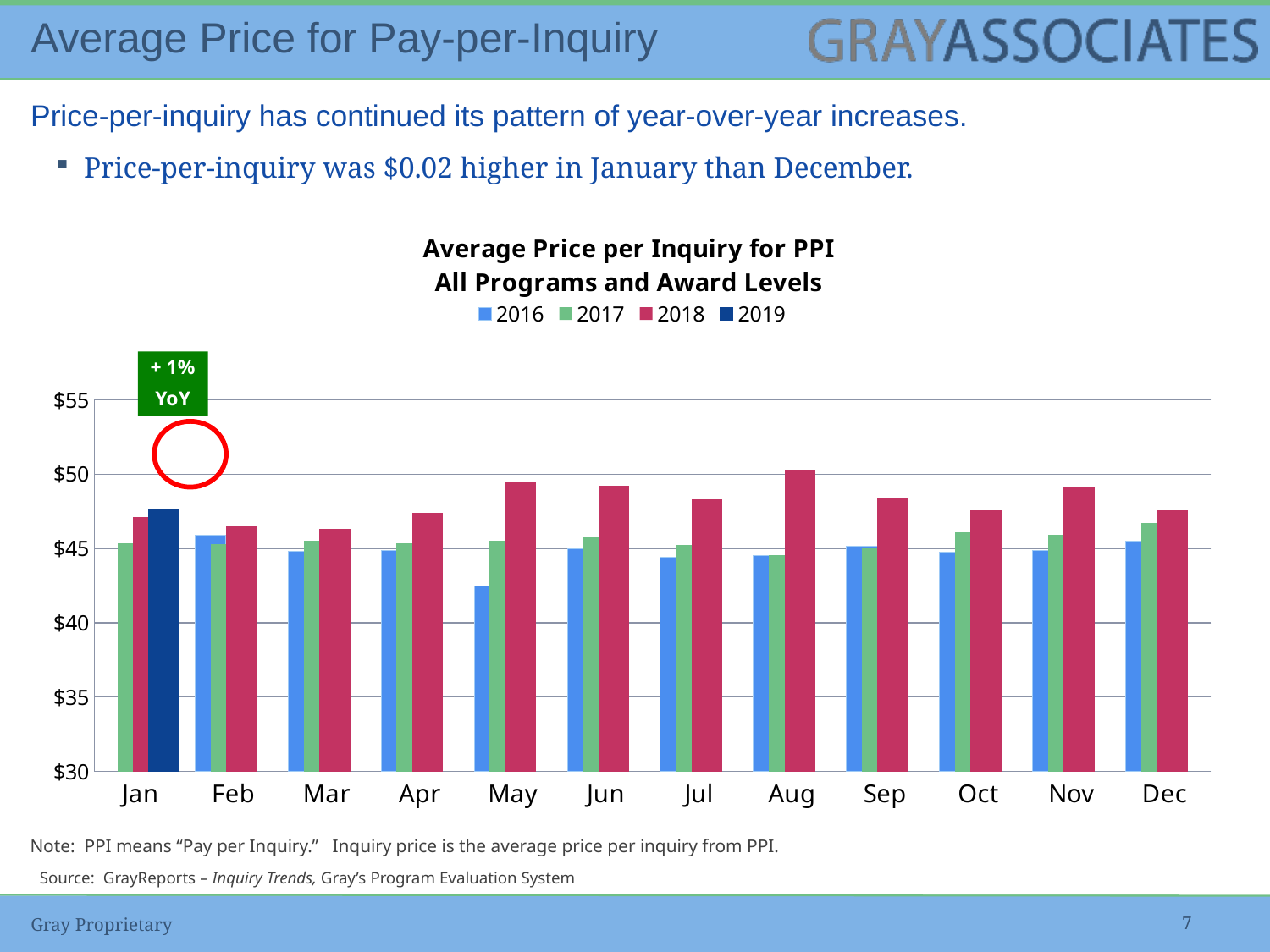
Is the 2018 value for Aug greater or less than $50? greater What kind of chart is shown on the slide? bar chart How many series does the chart legend list? 4 Which is larger for the 2018 series: Aug or Jul? Aug How many months are shown along the x axis of the chart? 12 Which month has the lowest value for the 2016 series? May Is the 2016 value for May greater or less than $45? less Which month has the highest value for the 2018 series? Aug Is the 2019 value for Jan greater or less than $50? less What year-over-year change is shown in the green annotation box above the Jan bars? + 1% YoY Which series is the only one with a bar for Jan but no other month? 2019